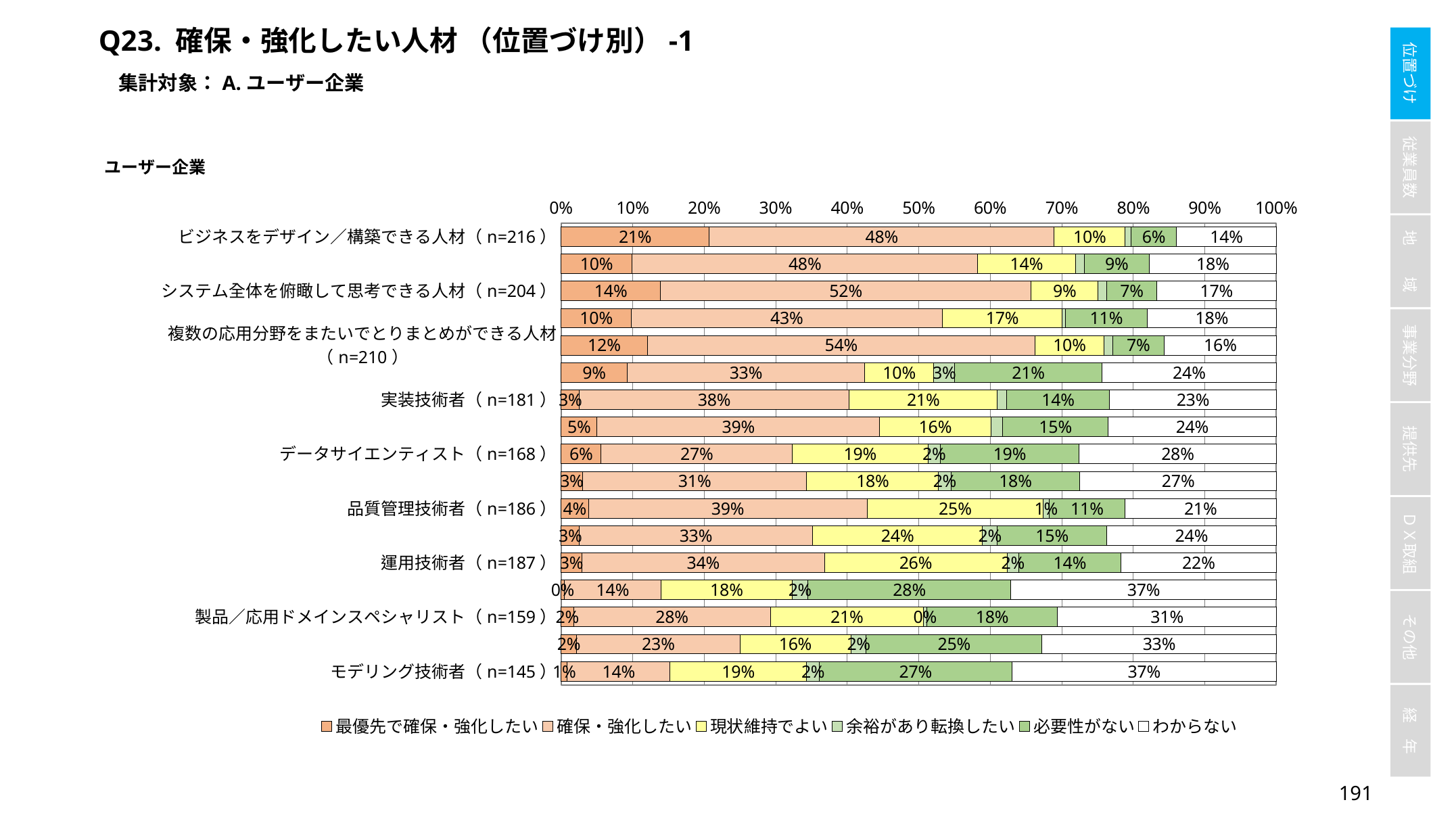
What is the value of 現状維持でよい for 実装技術者 (n=181)? 21% How many series does the legend list? 6 What is the value of わからない for モデリング技術者 (n=145)? 37% What is the value of 最優先で確保・強化したい for ビジネスをデザイン／構築できる人材 (n=216)? 21% Which has the larger 最優先で確保・強化したい value: ビジネスをデザイン／構築できる人材 (n=216) or システム全体を俯瞰して思考できる人材 (n=204)? ビジネスをデザイン／構築できる人材 (n=216) What is the value of 現状維持でよい for 運用技術者 (n=187)? 26% What is the value of 確保・強化したい for 複数の応用分野をまたいでとりまとめができる人材 (n=210)? 54% What kind of chart is shown on the slide? Stacked bar chart What is the value of 確保・強化したい for システム全体を俯瞰して思考できる人材 (n=204)? 52% What is the first entry in the chart's legend? 最優先で確保・強化したい What is the difference between the わからない values for データサイエンティスト (n=168) and 品質管理技術者 (n=186)? 7 percentage points What is the value of 必要性がない for 製品／応用ドメインスペシャリスト (n=159)? 18%